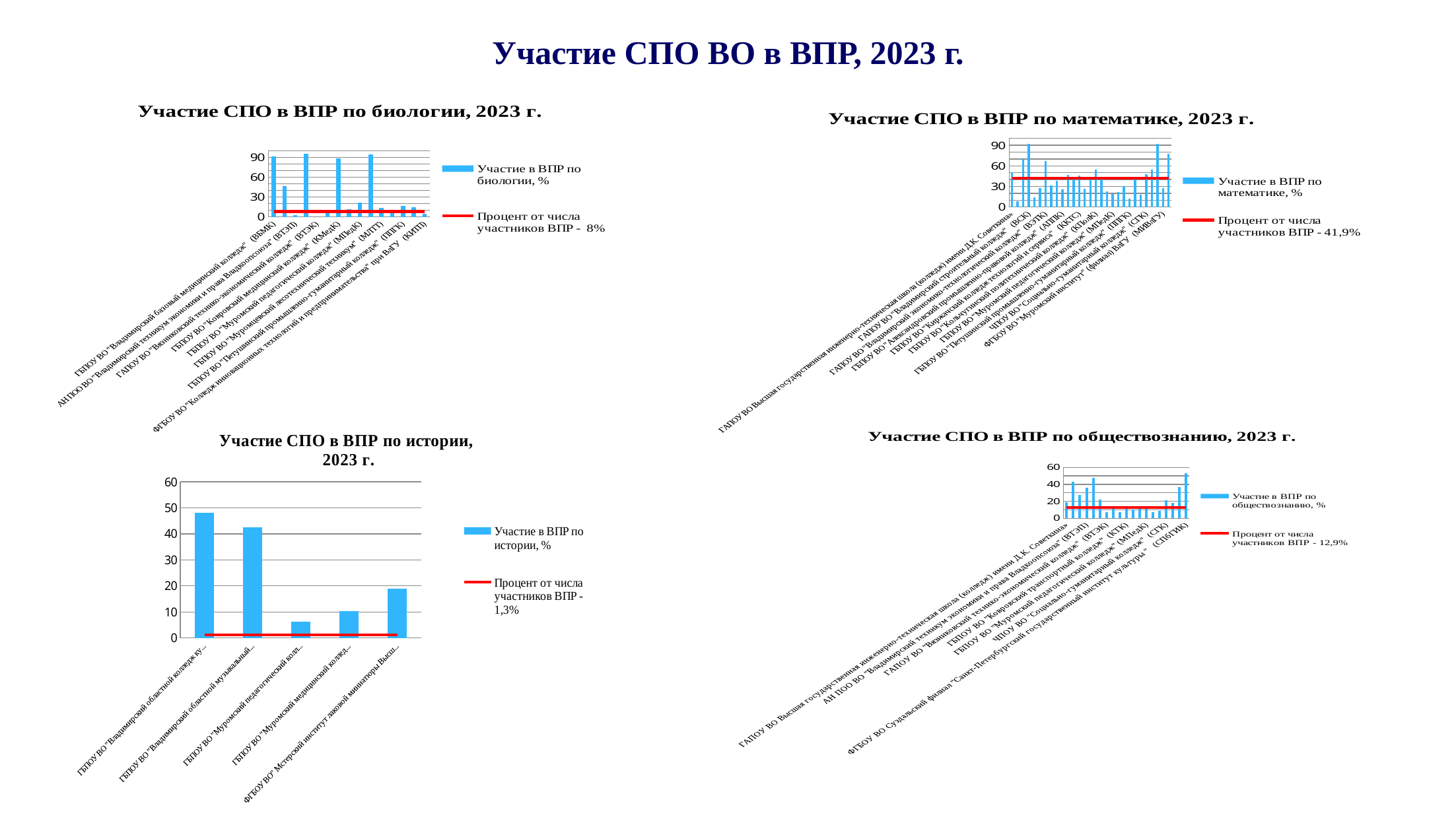
In the chart "Участие СПО в ВПР по биологии, 2023 г.", is the value for ГБПОУ ВО "Владимирский базовый медицинский колледж" (ВБМК) greater or less than 60? greater How many categories are plotted in the chart "Участие СПО в ВПР по истории, 2023 г."? 5 In the chart "Участие СПО в ВПР по истории, 2023 г.", is the value for ГБПОУ ВО "Владимирский областной колледж ку... greater or less than 40? greater In the chart "Участие СПО в ВПР по истории, 2023 г.", which category has the highest value? ГБПОУ ВО "Владимирский областной колледж ку... How many series does the legend list in the chart "Участие СПО в ВПР по математике, 2023 г."? 2 In the chart "Участие СПО в ВПР по истории, 2023 г.", which is larger: the value for ГБПОУ ВО "Владимирский областной музыкальный... or the value for ФГБОУ ВО "Мстерский институт лаковой миниатюры Высш...? ГБПОУ ВО "Владимирский областной музыкальный... In the chart "Участие СПО в ВПР по обществознанию, 2023 г.", what percentage is given in the legend entry for "Процент от числа участников ВПР"? 12,9% In the chart "Участие СПО в ВПР по математике, 2023 г.", what percentage is given in the legend entry for "Процент от числа участников ВПР"? 41,9% In the chart "Участие СПО в ВПР по истории, 2023 г.", is the value for ГБПОУ ВО "Муромский педагогический колл... greater or less than 10? less What kind of chart is "Участие СПО в ВПР по истории, 2023 г."? Combination bar and line chart How many series does the legend list in the chart "Участие СПО в ВПР по истории, 2023 г."? 2 In the chart "Участие СПО в ВПР по истории, 2023 г.", which category has the lowest value? ГБПОУ ВО "Муромский педагогический колл...